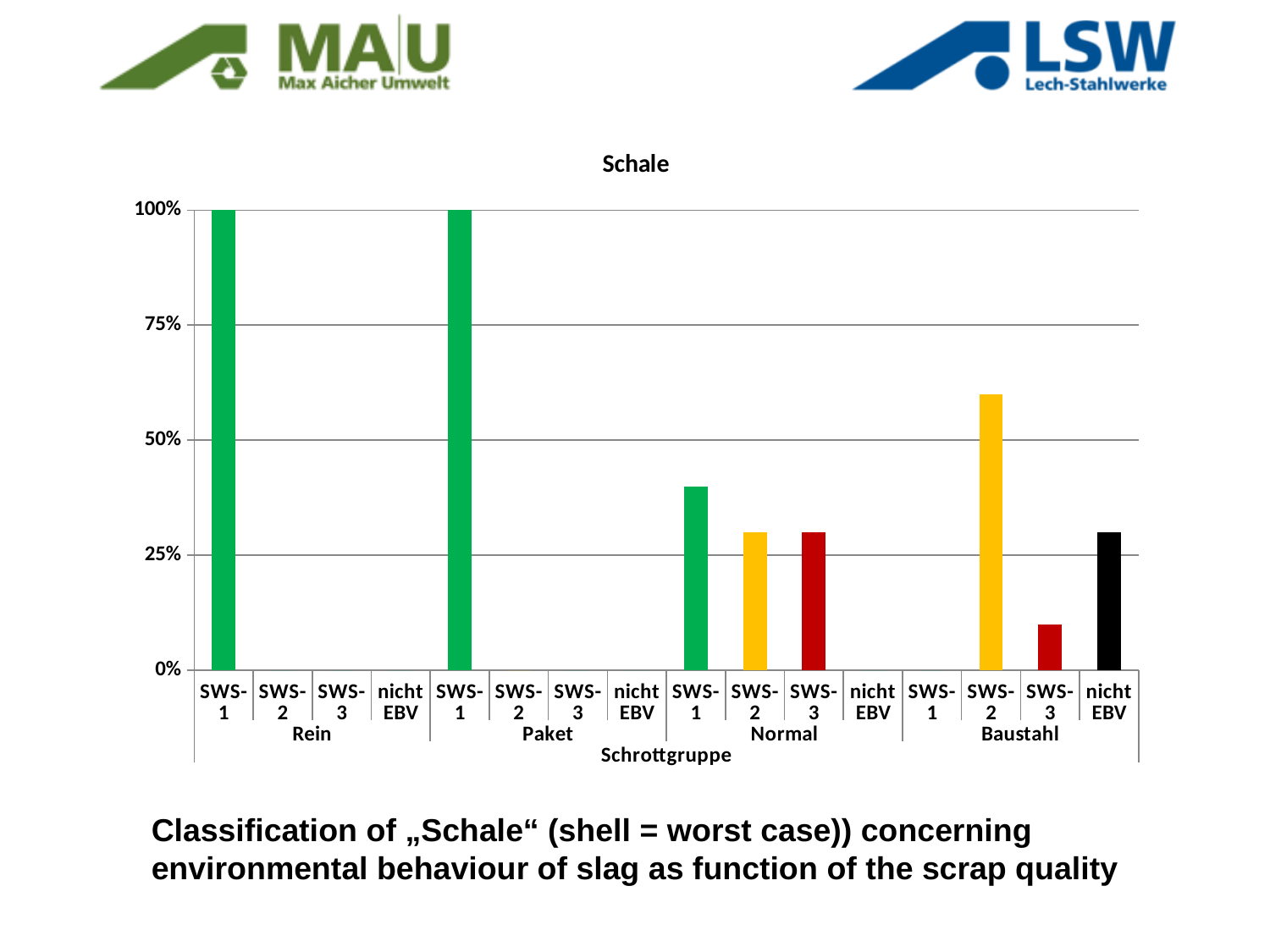
Is the value for SWS-2 in the Baustahl group greater or less than 50%? greater What is the value for SWS-1 in the Rein group? 100% Within the Baustahl group, which category has the highest value? SWS-2 How many scrap groups (Schrottgruppe) are shown along the x axis? 4 Is the value for SWS-1 in the Normal group greater or less than 50%? less In the Normal group, which is larger: SWS-1 or SWS-2? SWS-1 What is the title of the chart? Schale In the Baustahl group, which is larger: SWS-2 or nicht EBV? SWS-2 Is the value for SWS-3 in the Normal group greater or less than 50%? less What is the value for SWS-1 in the Paket group? 100% What kind of chart is shown on the slide? bar chart